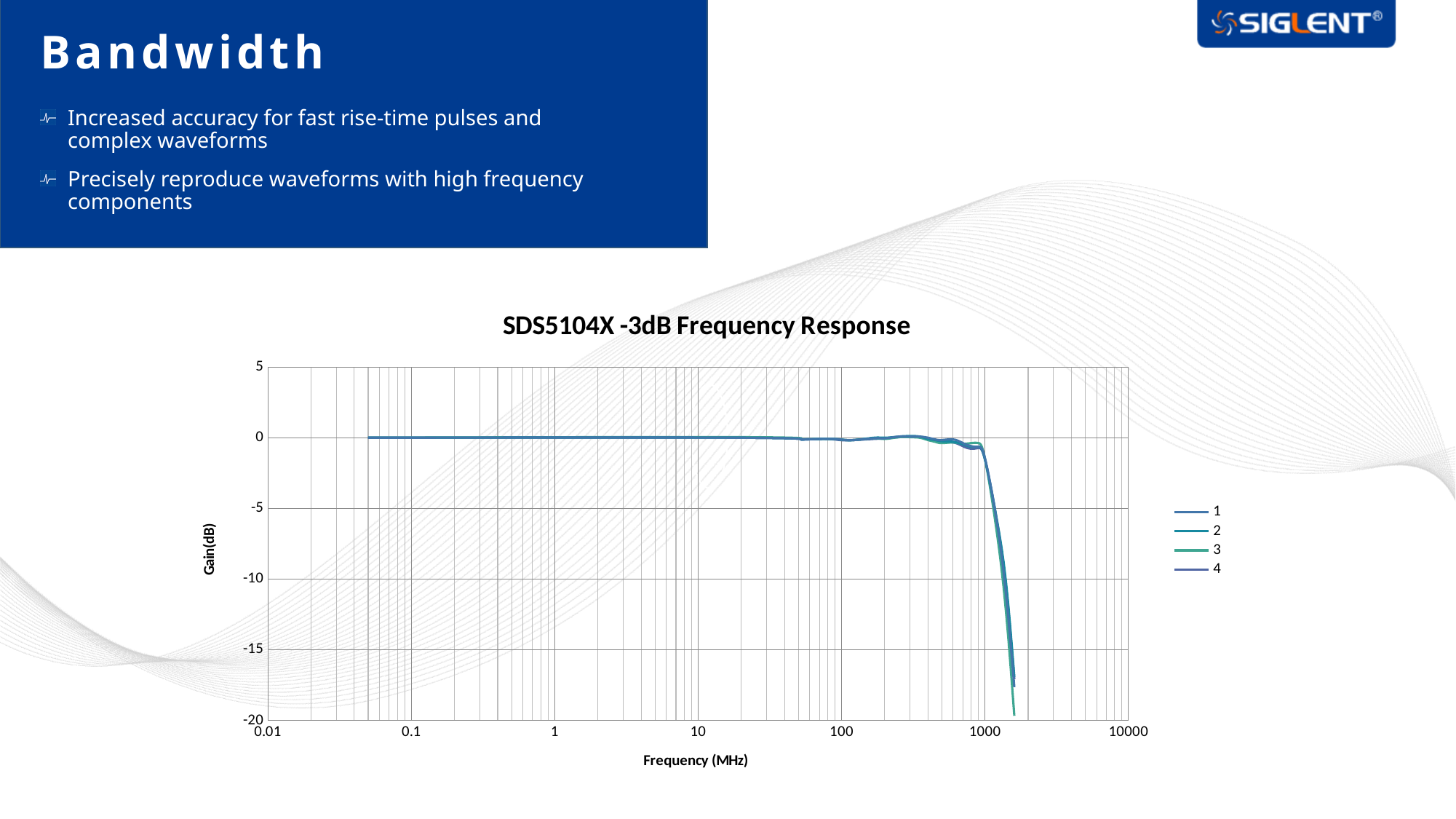
Is the gain at 10 MHz greater or less than -10 dB? greater What is the title of the chart? SDS5104X -3dB Frequency Response Is the gain at 100 MHz greater or less than -5 dB? greater What kind of chart is shown on the slide? line chart Is the gain at 1 MHz greater or less than -5 dB? greater Do the gain values rise or fall as the frequency moves past 1000 MHz? fall How many series does the legend of the chart list? 4 What is the label of the vertical axis of the chart? Gain(dB)